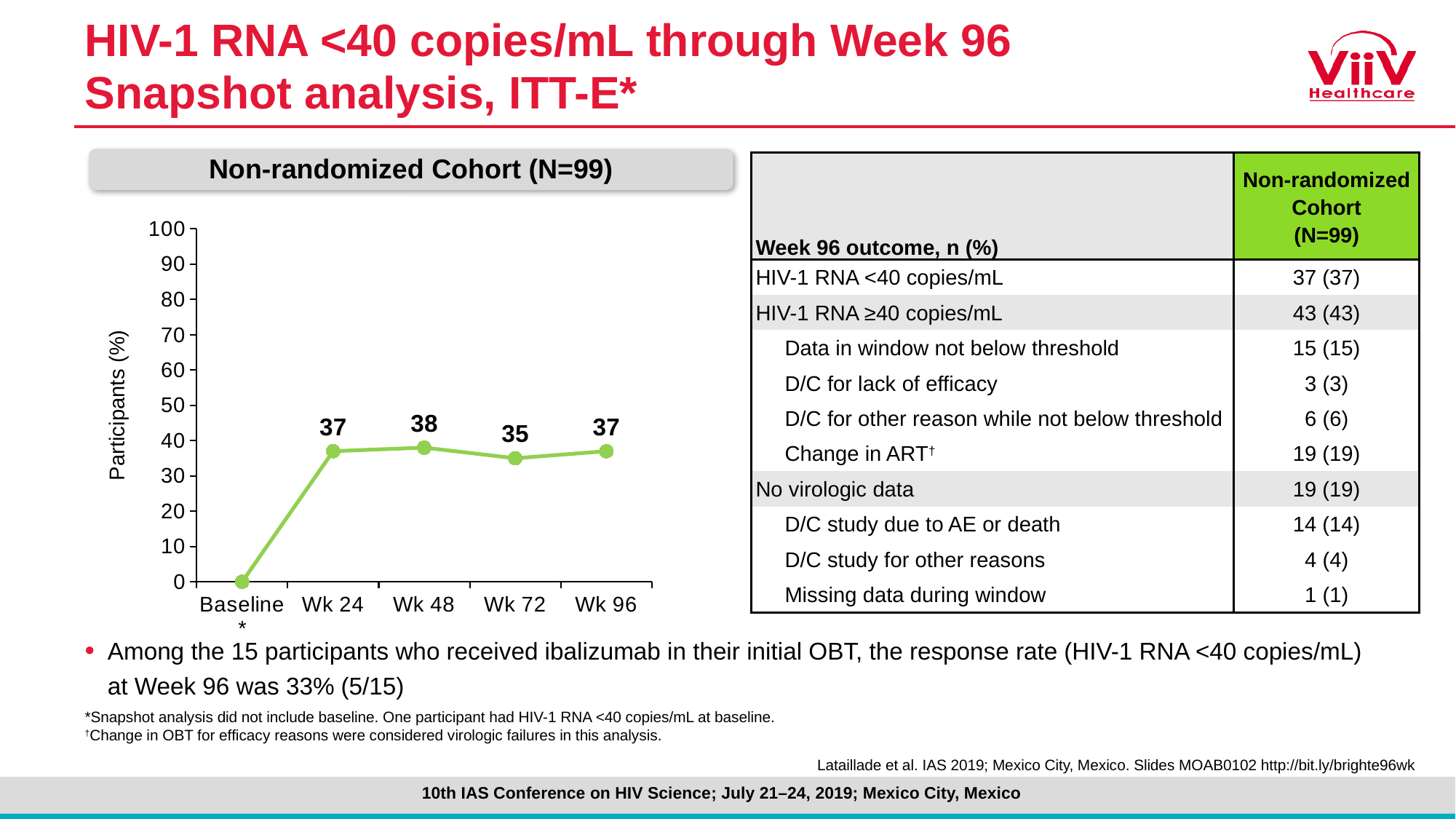
Which time point has the highest value in the Non-randomized Cohort chart? Wk 48 What is the difference between the values at Wk 48 and Wk 72 in the Non-randomized Cohort chart? 3 What type of chart is shown under the heading "Non-randomized Cohort (N=99)"? line chart What is the value plotted at Wk 72 in the Non-randomized Cohort chart? 35 Which time point has the lowest value in the Non-randomized Cohort chart? Baseline In the Non-randomized Cohort chart, is the value at Wk 48 larger or smaller than the value at Wk 72? larger Is the value at Wk 96 in the Non-randomized Cohort chart greater or less than 50? less What is the value plotted at Wk 24 in the Non-randomized Cohort chart? 37 What is the label of the y axis in the Non-randomized Cohort chart? Participants (%) How many time points are plotted on the x axis of the Non-randomized Cohort chart? 5 What is the value plotted at Wk 48 in the Non-randomized Cohort chart? 38 What is the value plotted at Wk 96 in the Non-randomized Cohort chart? 37